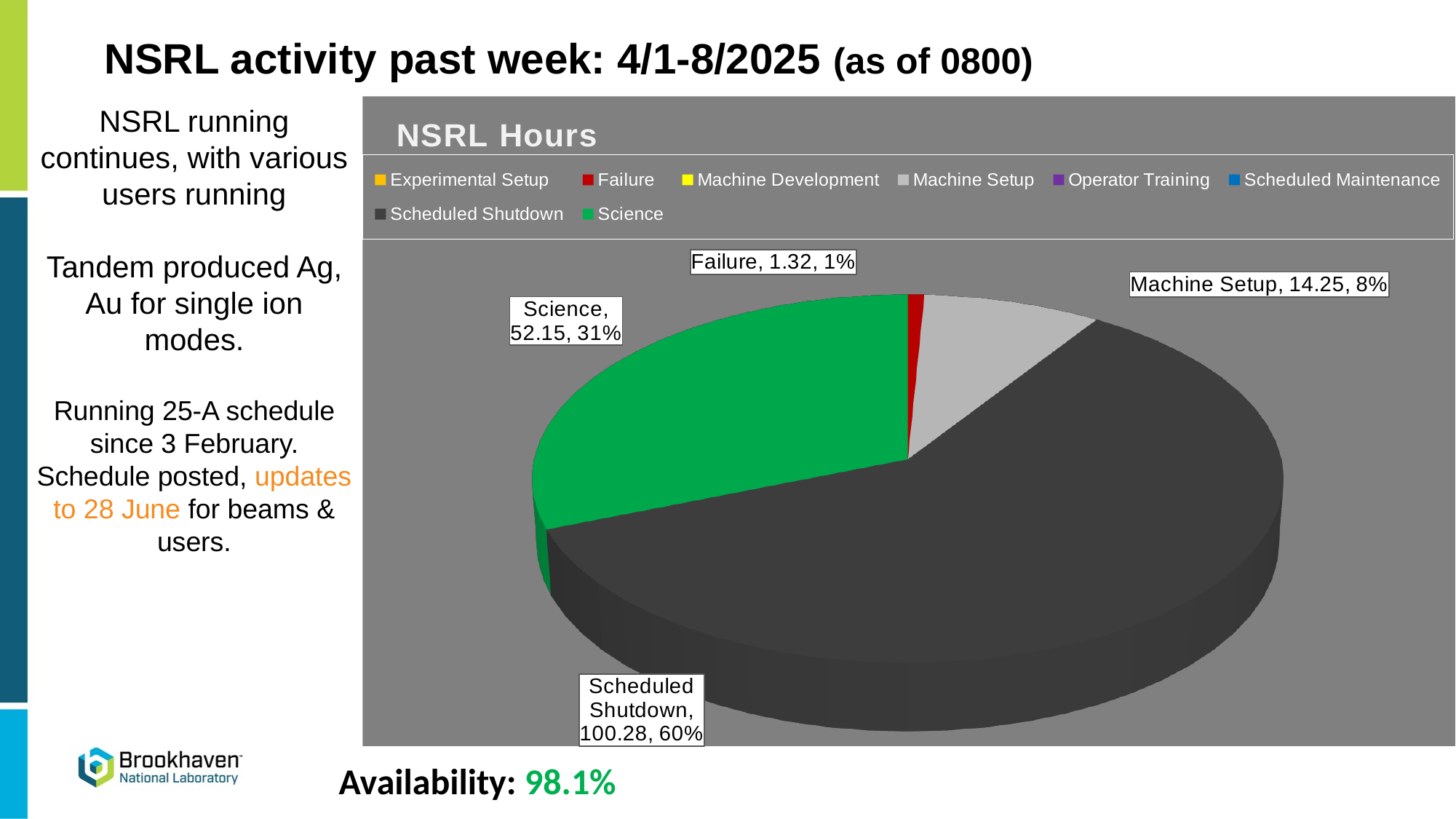
What is the difference in hours between Scheduled Shutdown and Science? 48.13 How many hours are shown for Science? 52.15 How many hours are shown for Machine Setup? 14.25 How many entries does the chart legend list? 8 Which labelled category has the largest slice of the pie? Scheduled Shutdown How many hours are shown for Failure? 1.32 How many hours are shown for Scheduled Shutdown? 100.28 Which labelled category has the smallest slice of the pie? Failure What share of the pie does Scheduled Shutdown represent? 60% What kind of chart is shown on the slide? Pie chart What is the title of the chart? NSRL Hours What share of the pie does Science represent? 31%